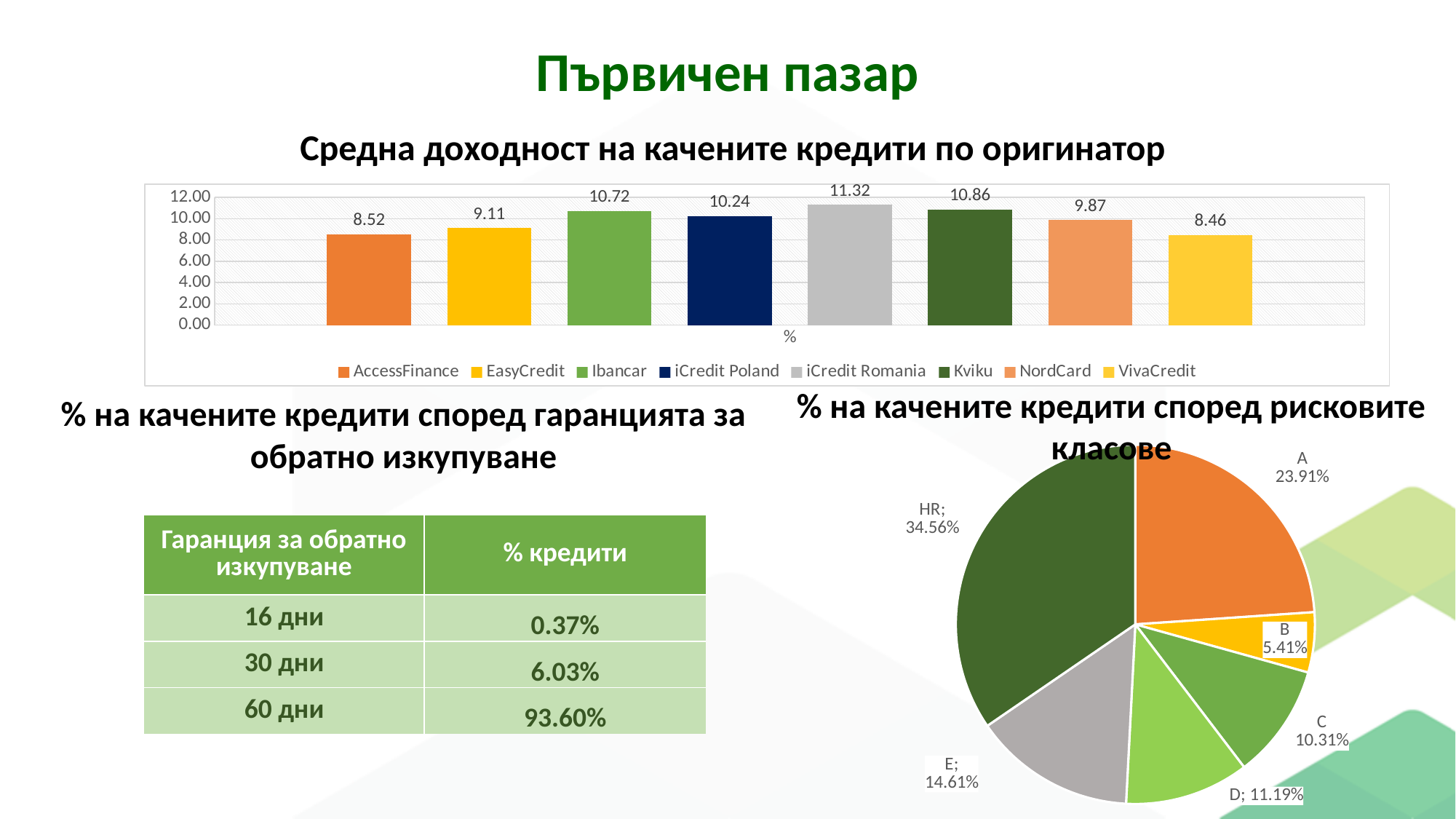
In the pie chart '% на качените кредити според рисковите класове', how many slices are there? 6 In the bar chart 'Средна доходност на качените кредити по оригинатор', what is the value for iCredit Romania? 11.32 In the bar chart 'Средна доходност на качените кредити по оригинатор', what is the difference between the values for Kviku and EasyCredit? 1.75 In the bar chart 'Средна доходност на качените кредити по оригинатор', what is the value for NordCard? 9.87 In the bar chart 'Средна доходност на качените кредити по оригинатор', which is larger, the value for Ibancar or the value for iCredit Poland? Ibancar In the bar chart 'Средна доходност на качените кредити по оригинатор', which originator has the lowest value? VivaCredit In the bar chart 'Средна доходност на качените кредити по оригинатор', how many entries does the legend list? 8 In the bar chart 'Средна доходност на качените кредити по оригинатор', how many originators are plotted? 8 In the pie chart '% на качените кредити според рисковите класове', which risk class has the smallest slice? B What type of chart is the chart titled 'Средна доходност на качените кредити по оригинатор'? bar chart In the pie chart '% на качените кредити според рисковите класове', what share does class HR have? 34.56% In the bar chart 'Средна доходност на качените кредити по оригинатор', which originator has the highest value? iCredit Romania